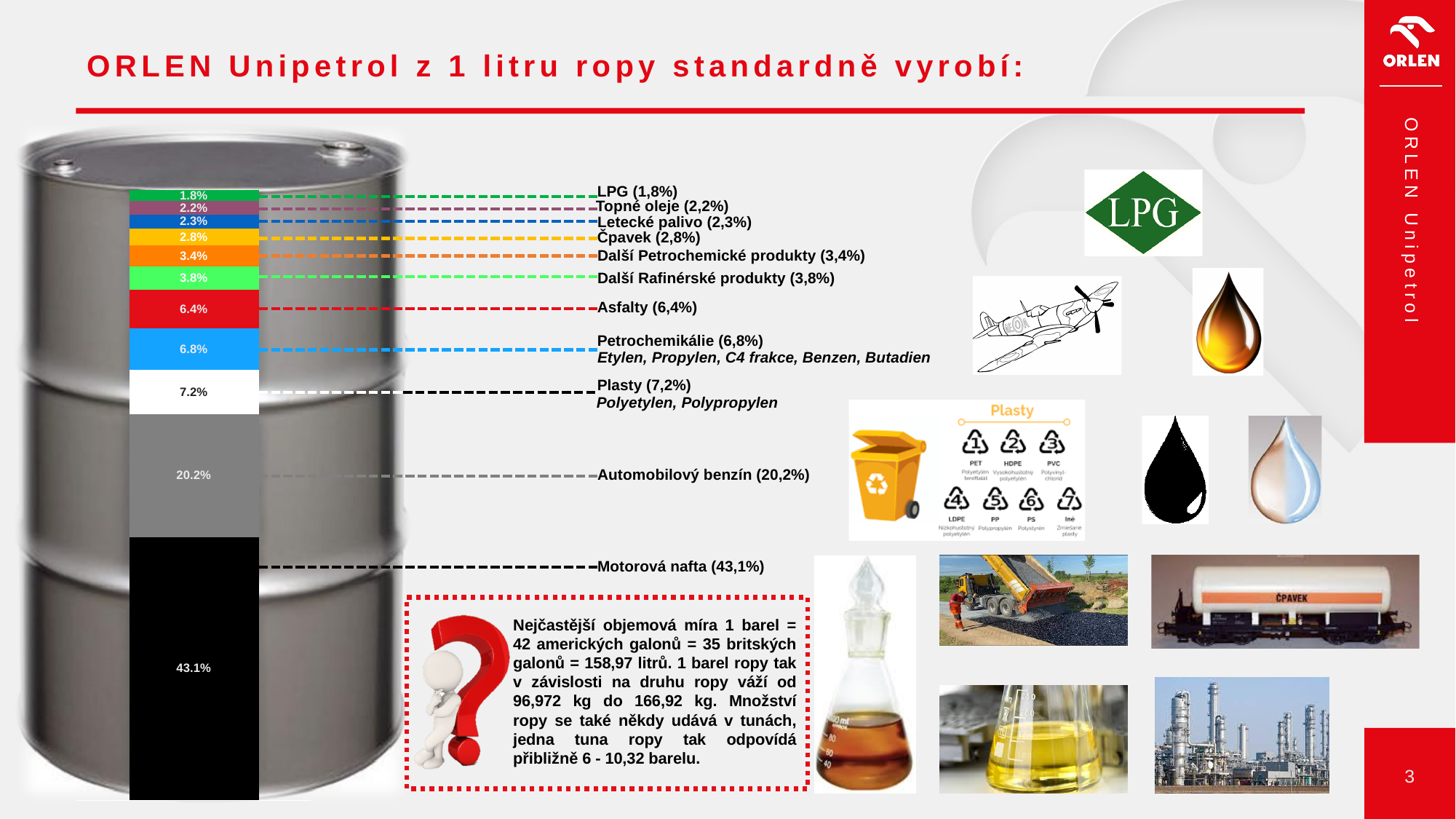
What percentage is shown for Asfalty? 6.4% Which is larger, the share of Petrochemikálie or the share of Asfalty? Petrochemikálie Which product has the largest share in the stacked bar? Motorová nafta What kind of chart is shown on the barrel? Stacked bar chart What is the difference between the shares of Motorová nafta and Automobilový benzín? 22.9% Which product has the smallest share in the stacked bar? LPG How many product segments make up the stacked bar? 11 What colour is the Motorová nafta segment of the bar? Black What is the total of all segments in the stacked bar? 100% What is the value shown for Automobilový benzín? 20.2% What share of the barrel does Motorová nafta account for? 43.1% What is the value for Čpavek? 2.8%